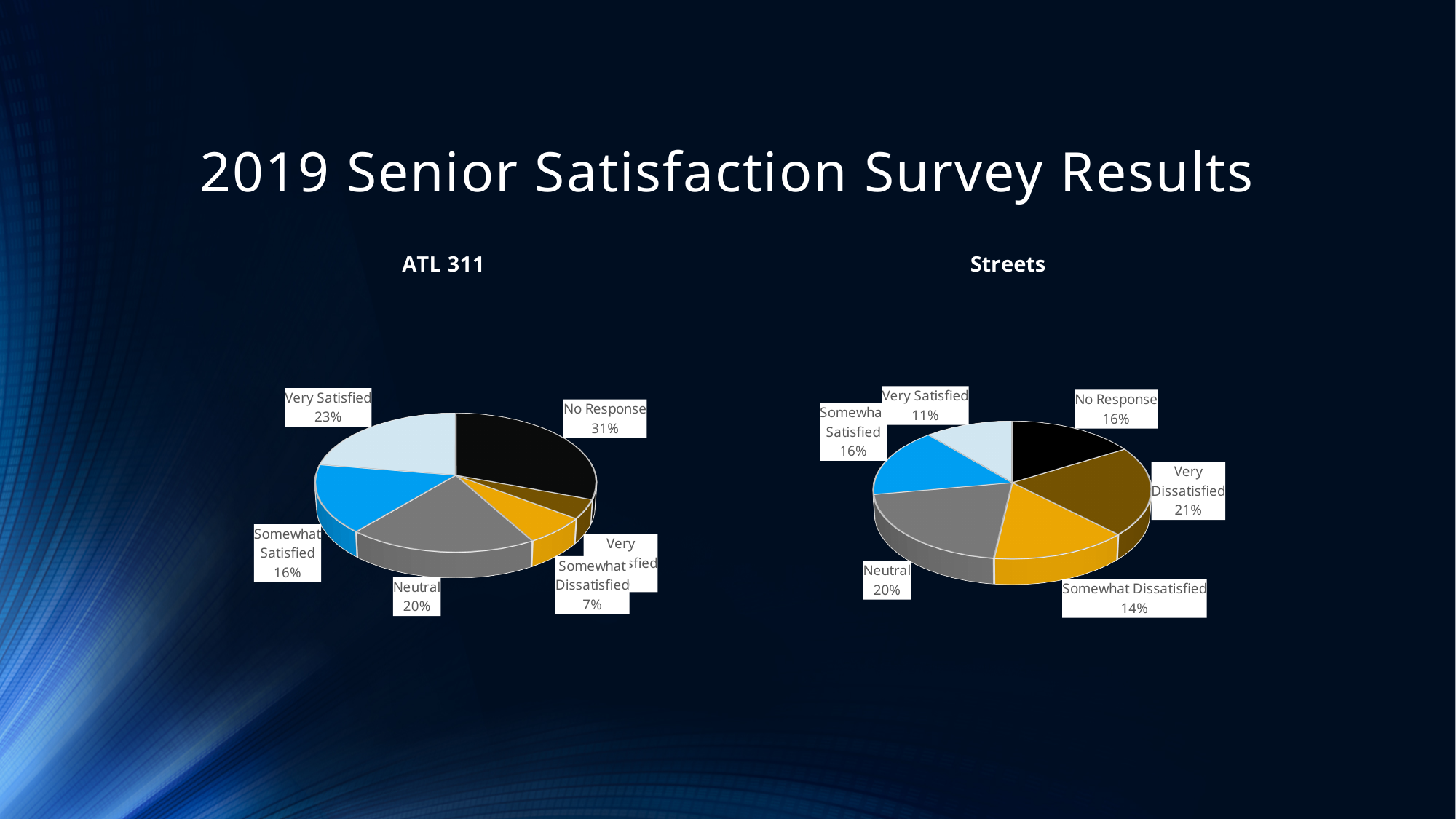
In the Streets chart, which category has the smallest share? Very Satisfied In the ATL 311 chart, what percentage of respondents gave No Response? 31% How many slices does the Streets pie chart have? 6 What type of chart is used for the ATL 311 results? Pie chart In the Streets chart, what percentage of respondents were Very Dissatisfied? 21% In the ATL 311 chart, what share of respondents were Very Satisfied? 23% In the ATL 311 chart, what percentage were Somewhat Dissatisfied? 7% In the ATL 311 chart, which category has the largest share? No Response In the Streets chart, what percentage of respondents were Neutral? 20% In the ATL 311 chart, what is the difference between the No Response share and the Very Satisfied share? 8% In the Streets chart, which is larger: the Somewhat Satisfied share or the Somewhat Dissatisfied share? Somewhat Satisfied In the Streets chart, which category has the largest share? Very Dissatisfied